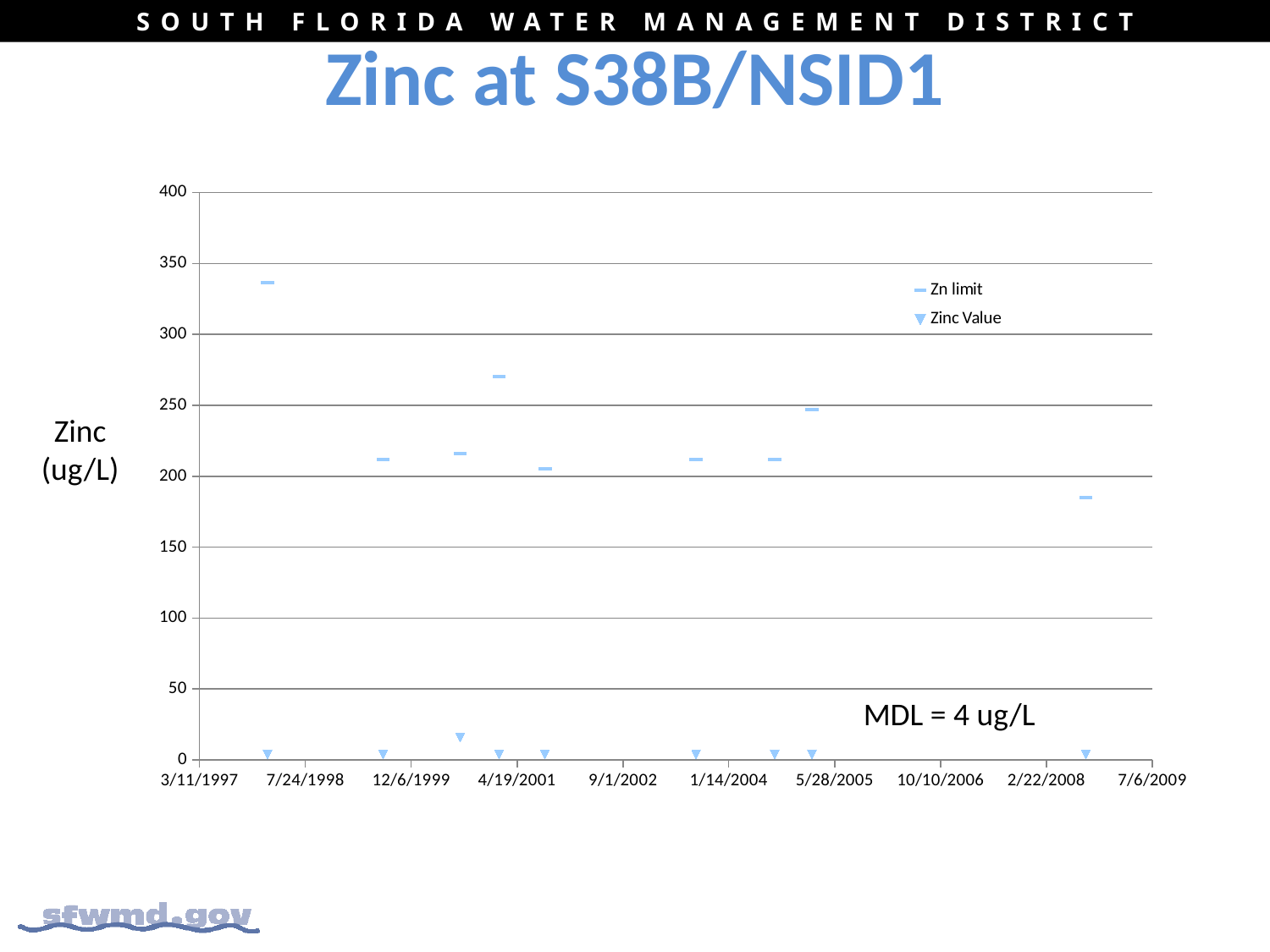
Which series has the larger values throughout the chart, Zn limit or Zinc Value? Zn limit How many series does the legend list? 2 What are the two series named in the legend? Zn limit and Zinc Value Is the highest Zn limit point (the earliest one, near 1998) greater or less than 300? greater Are all the Zinc Value points greater or less than 50? less Is the Zn limit point near 2001 (the one above 250) greater or less than 250? greater What is the highest value shown on the y axis? 400 What MDL value is annotated on the chart? MDL = 4 ug/L What is the title of the chart? Zinc at S38B/NSID1 Do the Zinc Value points rise, fall, or stay roughly flat across the x axis? stay roughly flat What kind of chart is shown on the slide? scatter chart